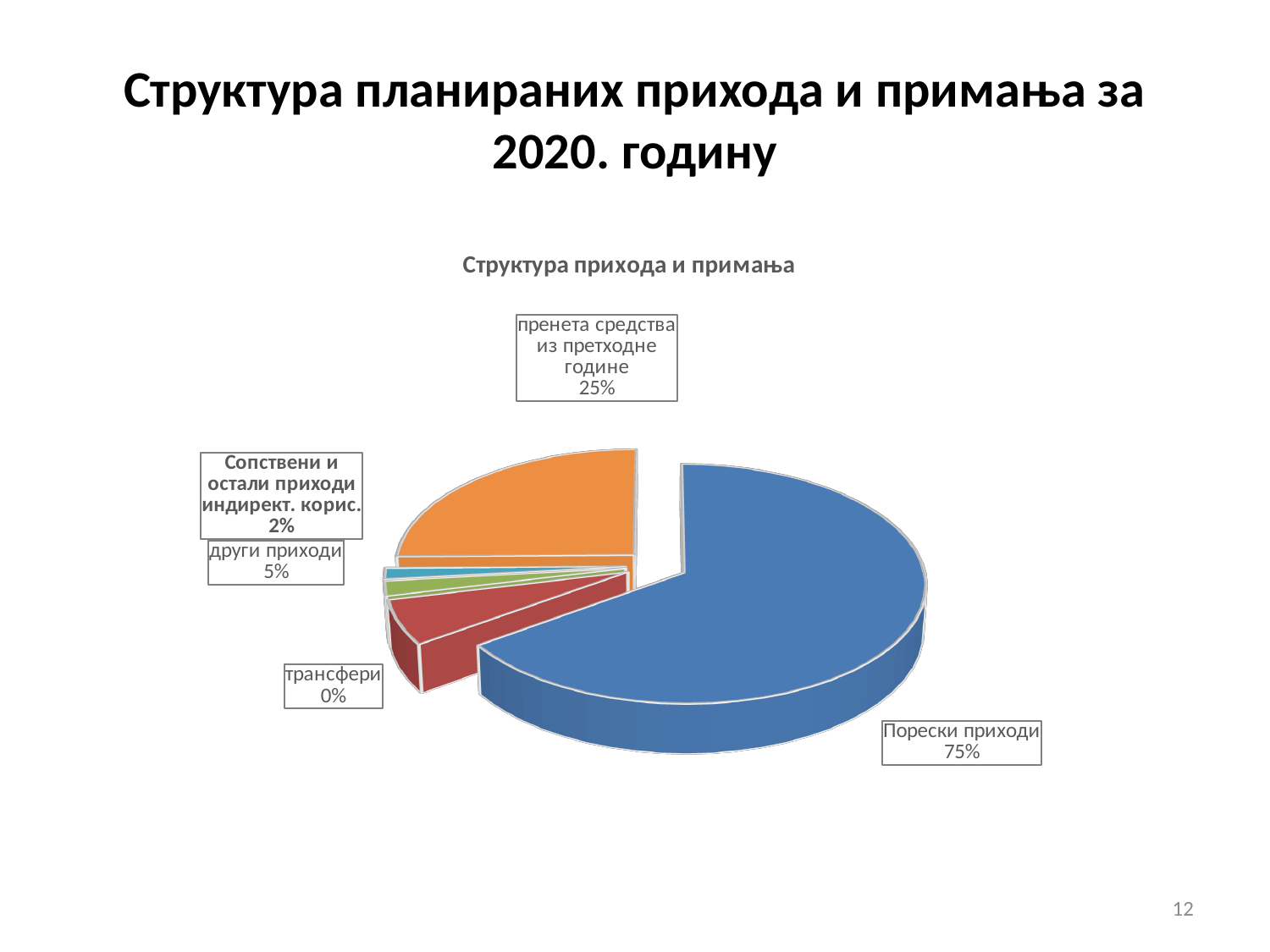
What share of the pie is labelled for Порески приходи? 75% What share of the pie is labelled for трансфери? 0% What share of the pie is labelled for пренета средства из претходне године? 25% Which is larger, the share for други приходи or the share for Сопствени и остали приходи индирект. корис.? други приходи What is the chart's title? Структура прихода и примања What kind of chart is shown on the slide? pie chart Which slice of the pie is the largest? Порески приходи How many slices are labelled on the pie chart? 5 What is the difference in percentage points between the Порески приходи share and the пренета средства из претходне године share? 50